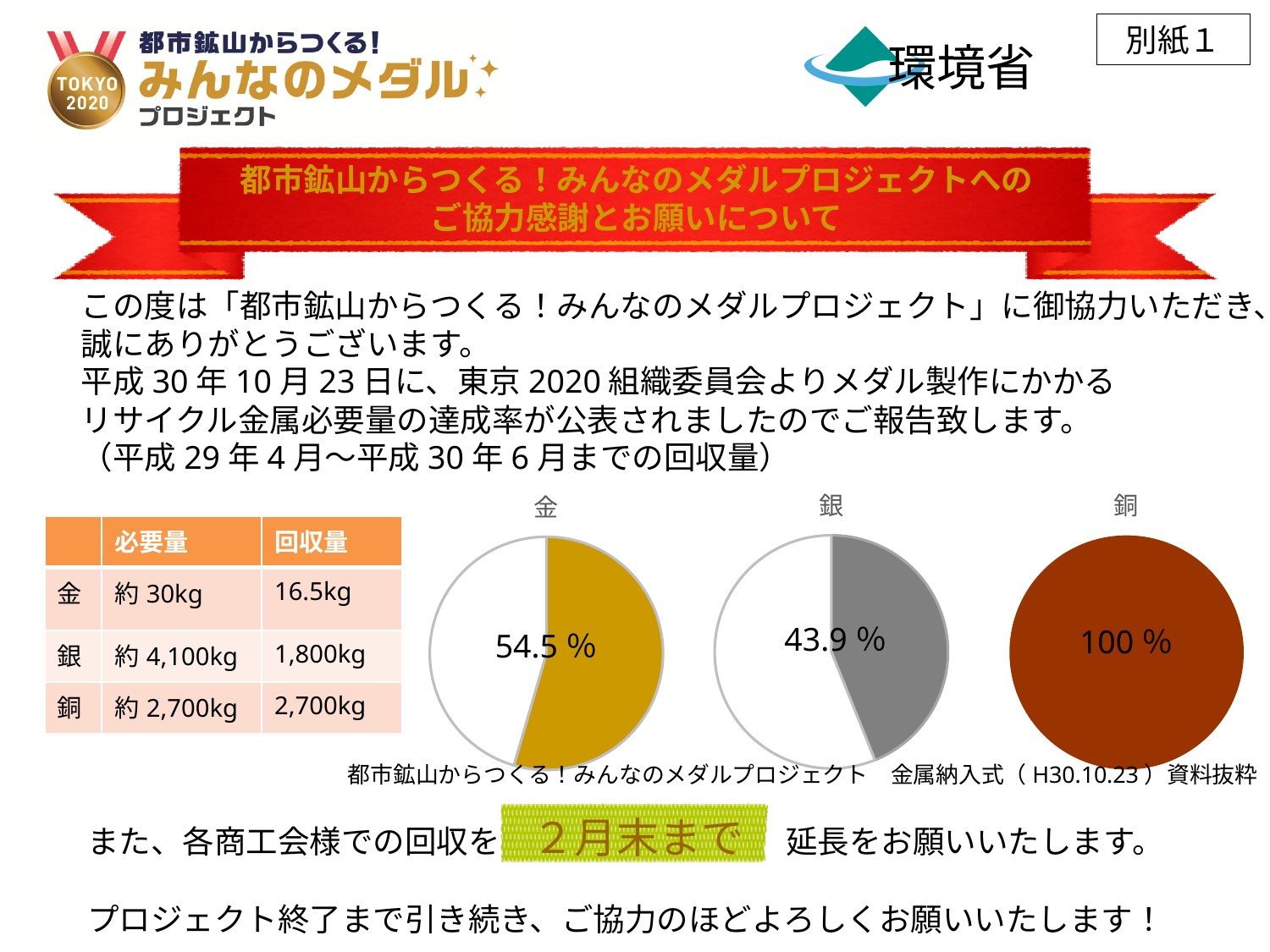
What is the difference in percentage points between the 金 pie chart (54.5 %) and the 銀 pie chart (43.9 %)? 10.6 In the pie chart titled 金, what percentage is shown for the filled slice? 54.5 % In the pie chart titled 銀, what percentage is shown for the filled slice? 43.9 % Which of the three pie charts (金, 銀, 銅) shows the lowest percentage? 銀 What colour is the filled slice in the 金 pie chart? Gold (yellow-orange) Comparing the 金 and 銀 pie charts, which shows the larger percentage? 金 In the 銀 pie chart, is the filled slice greater or less than 50%? less What kind of chart is used to show the achievement rates for 金, 銀 and 銅? Pie chart How many pie charts are shown on the slide? 3 What is the title of the leftmost pie chart? 金 Which of the three pie charts (金, 銀, 銅) shows the highest percentage? 銅 In the pie chart titled 銅, what percentage is shown? 100 %